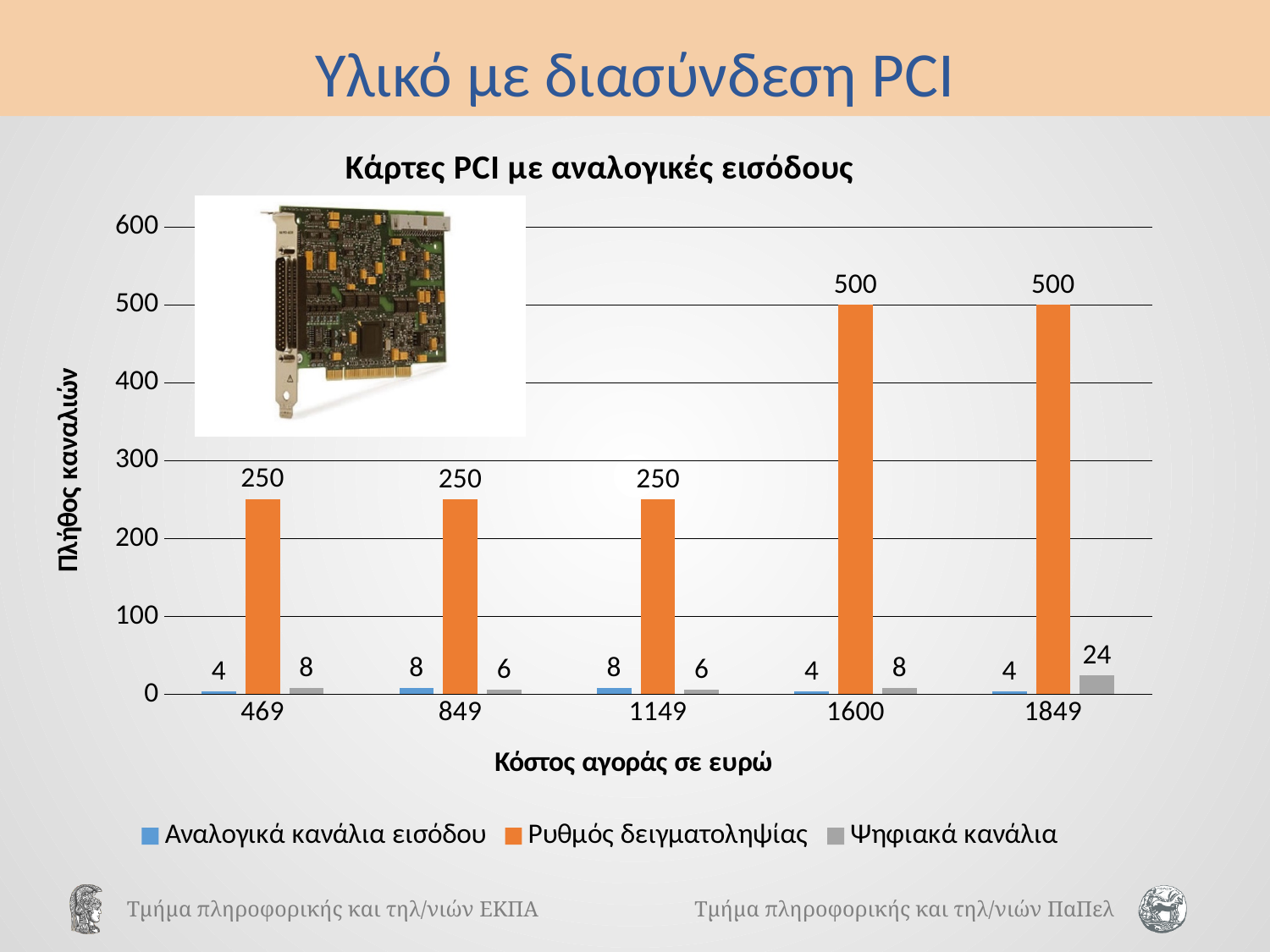
What is the difference between Ρυθμός δειγματοληψίας for the card costing 1849 and the card costing 469? 250 What is the value of Ψηφιακά κανάλια for the card costing 1849? 24 What type of chart is shown on the slide? bar chart What is the title of the chart? Κάρτες PCI με αναλογικές εισόδους What is the value of Αναλογικά κανάλια εισόδου for the card costing 849? 8 How many series does the legend list? 3 How many cost categories are shown on the x axis? 5 Is the value of Ρυθμός δειγματοληψίας for the card costing 1149 greater or less than 300? less Which is larger: Ψηφιακά κανάλια for the card costing 469 or for the card costing 849? 469 What is the value of Ρυθμός δειγματοληψίας for the card costing 1600? 500 What is the label of the y axis? Πλήθος καναλιών Which cost category has the highest value for Ψηφιακά κανάλια? 1849